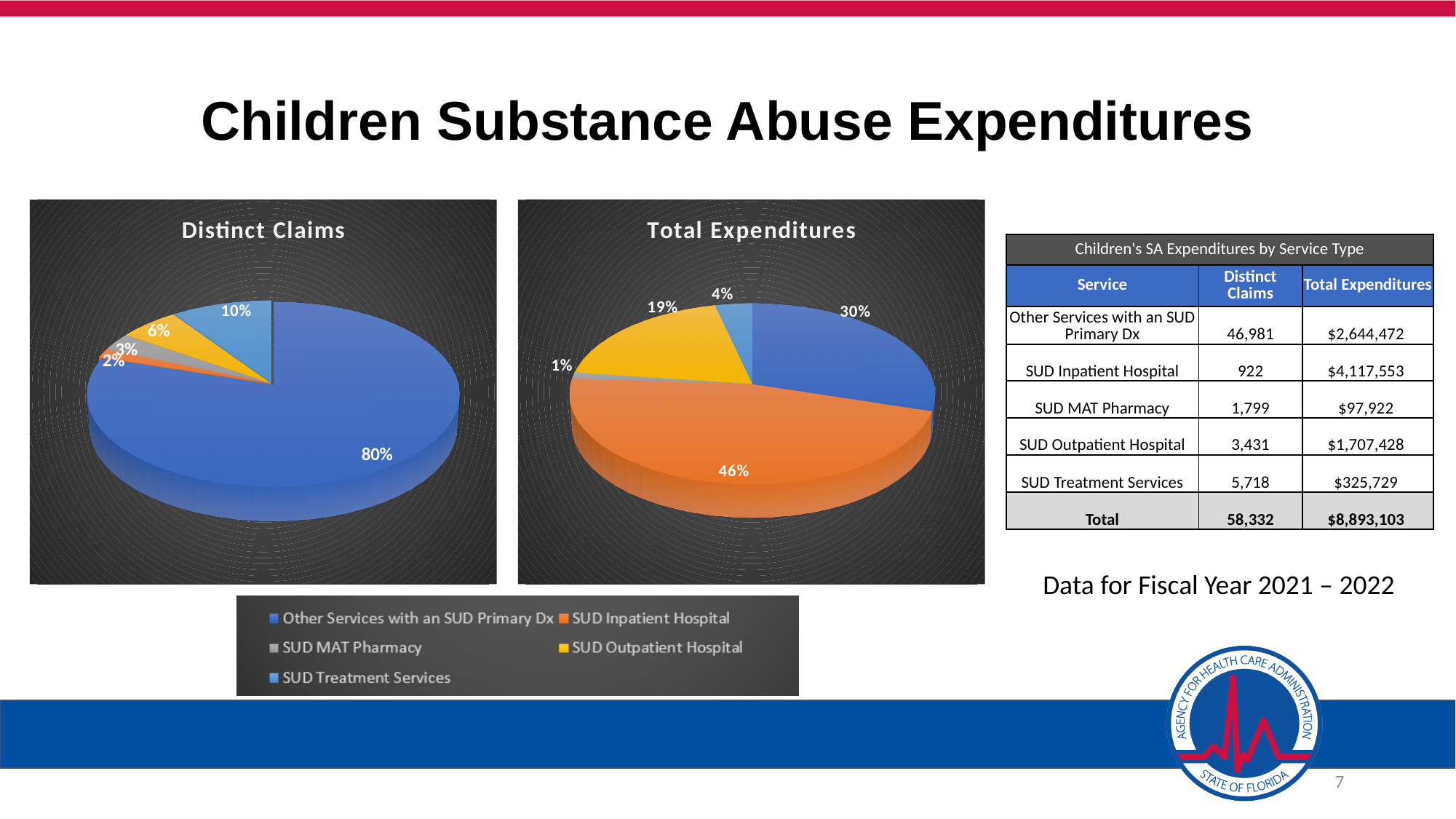
In the "Distinct Claims" chart, what share does SUD Treatment Services have? 10% In the "Total Expenditures" chart, what is the difference in percentage points between SUD Inpatient Hospital and Other Services with an SUD Primary Dx? 16 percentage points In the "Distinct Claims" chart, which category has the smallest slice? SUD Inpatient Hospital What colour represents SUD Outpatient Hospital in the pie charts? Yellow What kind of chart is the "Distinct Claims" chart? Pie chart How many categories does the shared legend list for the pie charts? 5 In the "Total Expenditures" chart, which category has the largest slice? SUD Inpatient Hospital In the "Total Expenditures" chart, which category has the smallest slice? SUD MAT Pharmacy In the "Total Expenditures" chart, what share does SUD Outpatient Hospital have? 19% In the "Total Expenditures" chart, what share does SUD Inpatient Hospital have? 46% In the "Distinct Claims" chart, which is larger: SUD Outpatient Hospital or SUD MAT Pharmacy? SUD Outpatient Hospital